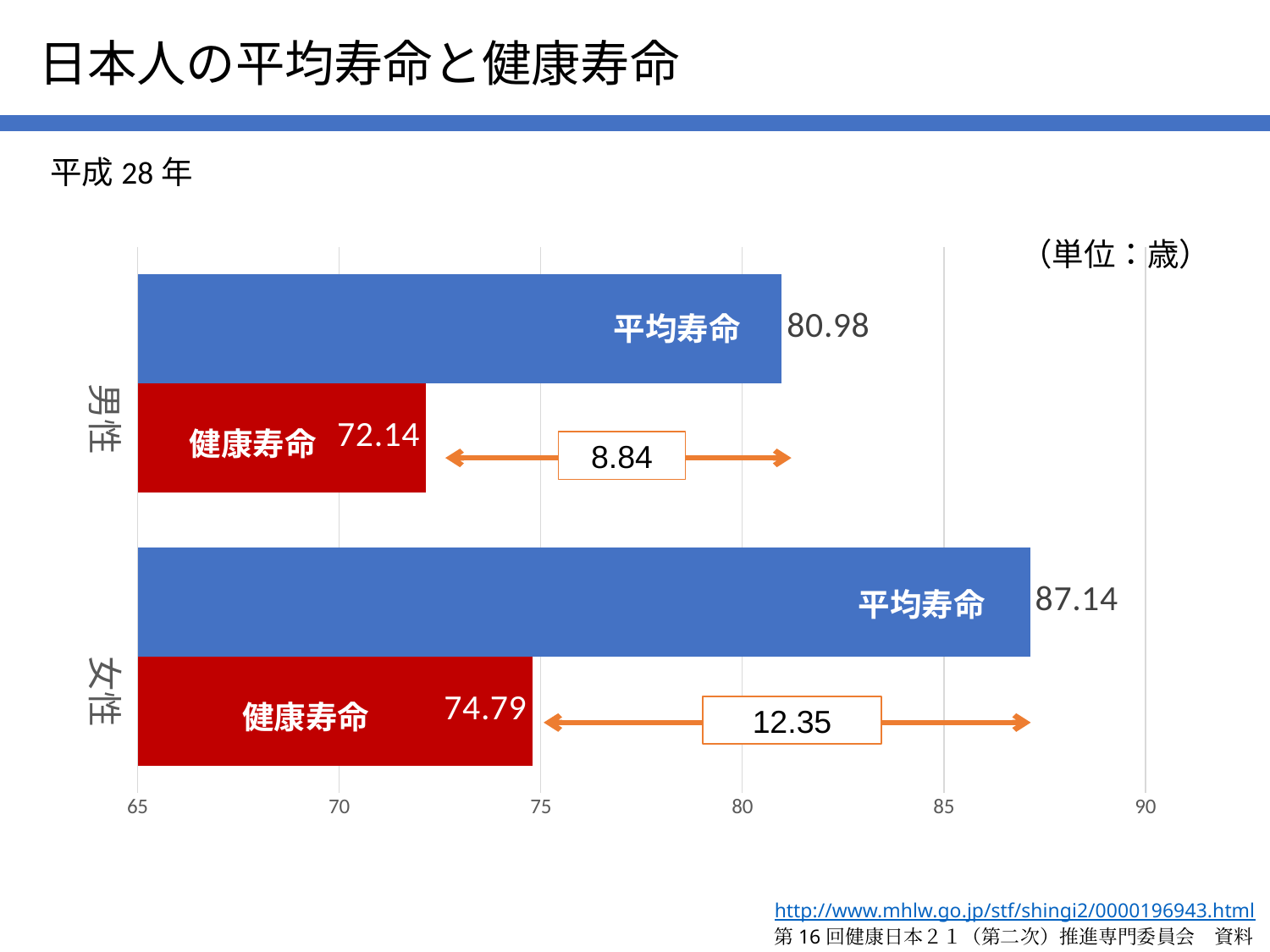
What unit is indicated for the values in the chart? 歳 Which group has the higher 平均寿命, 男性 or 女性? 女性 What is the difference between 平均寿命 and 健康寿命 for 男性? 8.84 Which of the four plotted values is the highest? 女性 平均寿命 (87.14) What is the 平均寿命 (average life expectancy) value for 男性 (men)? 80.98 What is the 平均寿命 value for 女性? 87.14 What is the difference between 平均寿命 and 健康寿命 for 女性? 12.35 What is the 健康寿命 (healthy life expectancy) value for 女性 (women)? 74.79 Which of the four plotted values is the lowest? 男性 健康寿命 (72.14) What kind of chart is shown on the slide? bar chart What is the 健康寿命 value for 男性? 72.14 Is the 健康寿命 value for 女性 greater or less than 75? less